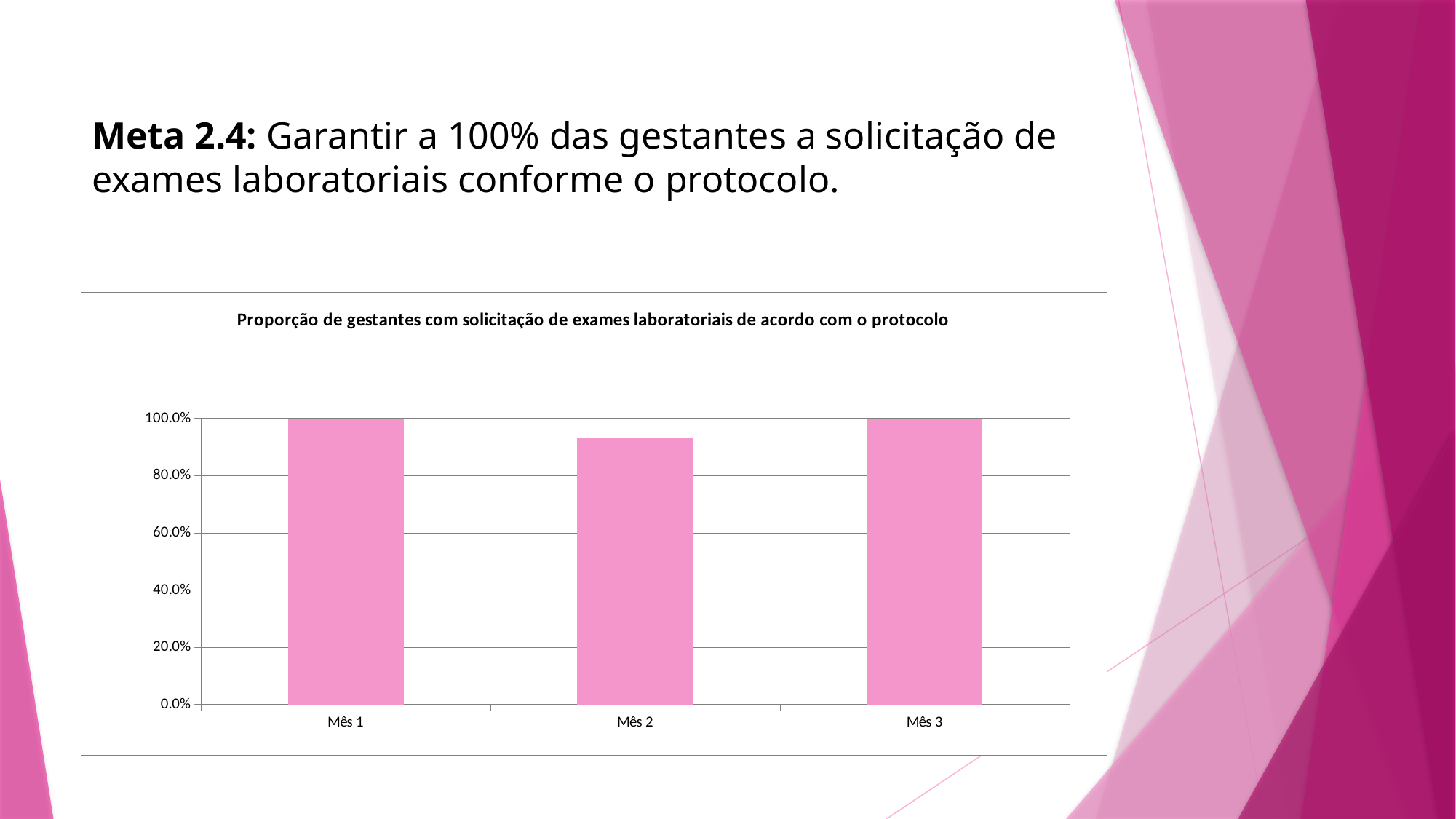
How many months (categories) are plotted in the chart? 3 What is the title of the chart? Proporção de gestantes com solicitação de exames laboratoriais de acordo com o protocolo What kind of chart is shown on the slide? Bar chart Which month has the lowest value? Mês 2 Which is larger, the value for Mês 2 or the value for Mês 3? Mês 3 Is the value for Mês 2 greater or less than 80.0%? greater What is the value for Mês 1? 100.0% What colour are the bars in the chart? Pink Is the value for Mês 2 greater or less than 100.0%? less Which is larger, the value for Mês 1 or the value for Mês 2? Mês 1 What is the highest value shown on the vertical axis? 100.0% What is the value for Mês 3? 100.0%